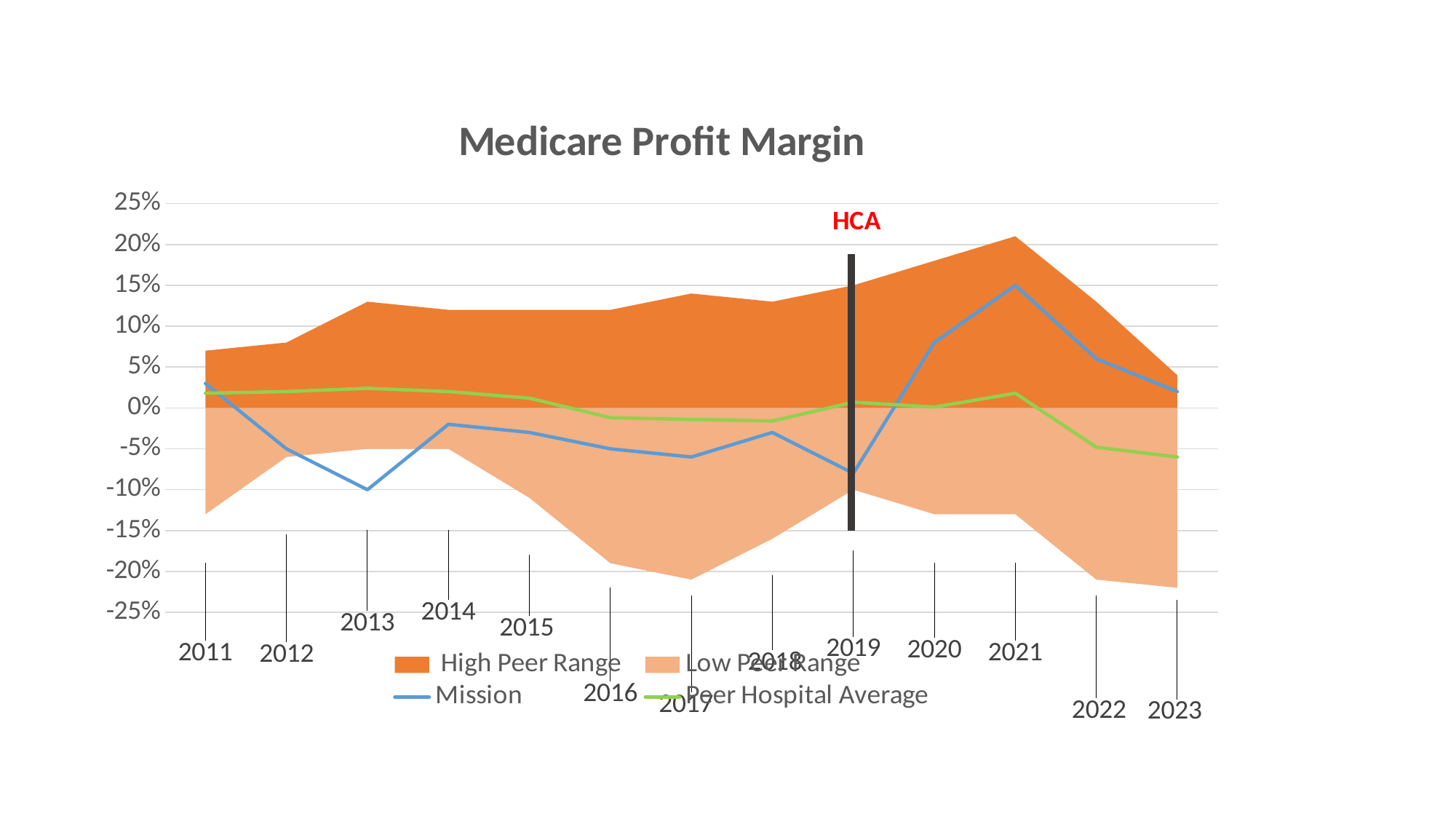
Is the Mission value for 2021 greater or less than 10%? greater In which year does the Mission line reach its lowest value? 2013 How many series does the legend list? 4 Is the Peer Hospital Average value for 2023 greater or less than 0%? less How many years are shown on the x axis? 13 Does the Mission line rise or fall from 2021 to 2023? fall What is the title of the chart? Medicare Profit Margin Is the Mission value for 2020 greater or less than 5%? greater In 2013, which is larger: Mission or Peer Hospital Average? Peer Hospital Average In 2021, which is larger: Mission or Peer Hospital Average? Mission In which year does the Mission line reach its highest value? 2021